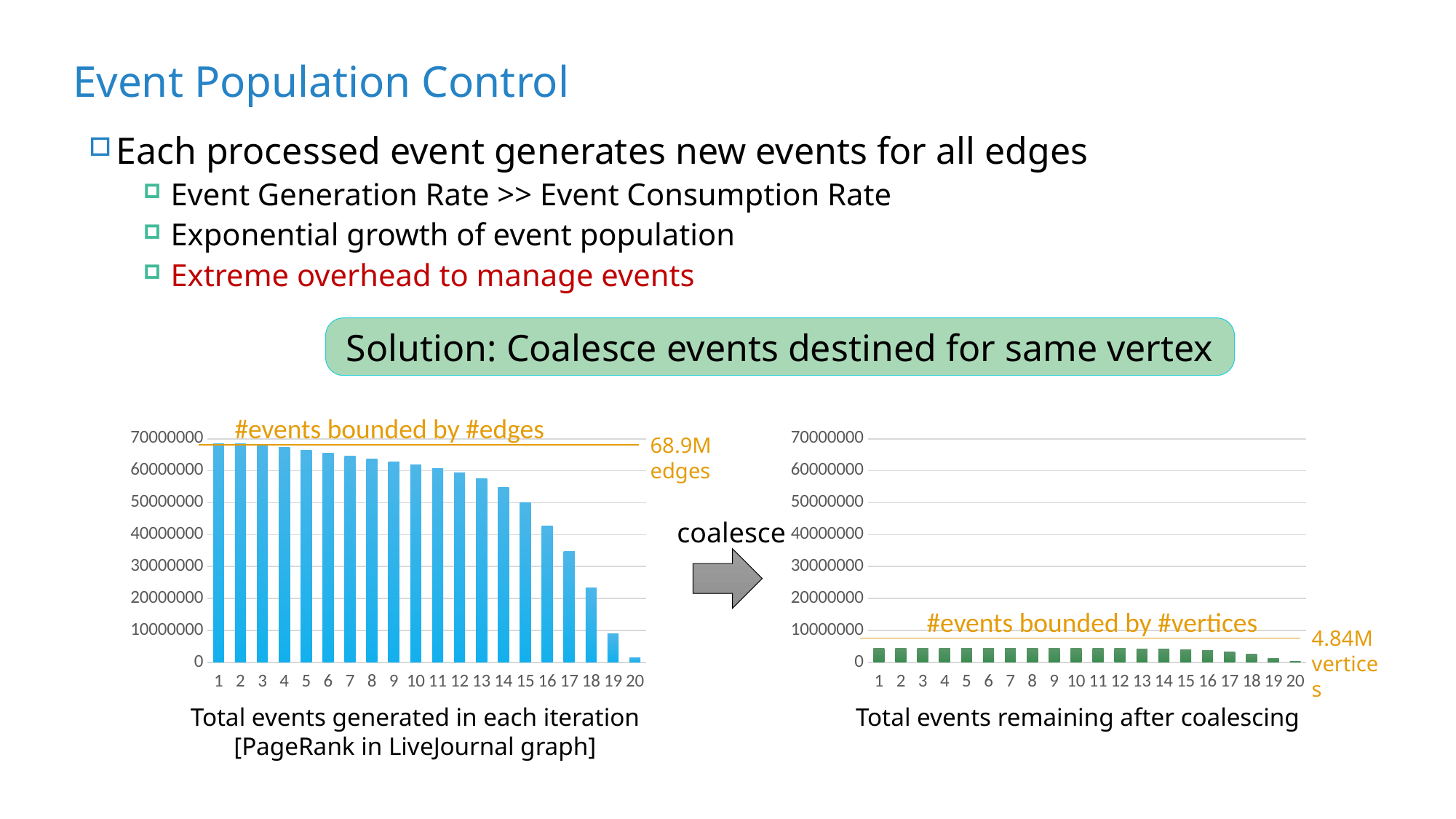
In the right chart, 'Total events remaining after coalescing', is the value for iteration 1 greater or less than 10000000? less What kind of chart is the left chart, 'Total events generated in each iteration'? bar chart In the left chart, 'Total events generated in each iteration', is the value for iteration 17 greater or less than 30000000? greater In the left chart, 'Total events generated in each iteration', is the value for iteration 18 greater or less than 30000000? less How many iterations are shown on the x axis of the right chart, 'Total events remaining after coalescing'? 20 In the left chart, 'Total events generated in each iteration', which iteration has the lowest value? 20 How many iterations are shown on the x axis of the left chart, 'Total events generated in each iteration'? 20 According to the annotation on the right chart, 'Total events remaining after coalescing', how many vertices bound the number of events? 4.84M vertices According to the annotation on the left chart, 'Total events generated in each iteration', how many edges bound the number of events? 68.9M edges In the left chart, 'Total events generated in each iteration', which is larger, the value for iteration 5 or the value for iteration 15? iteration 5 In the left chart, 'Total events generated in each iteration', do the values rise or fall as the iteration number increases? fall